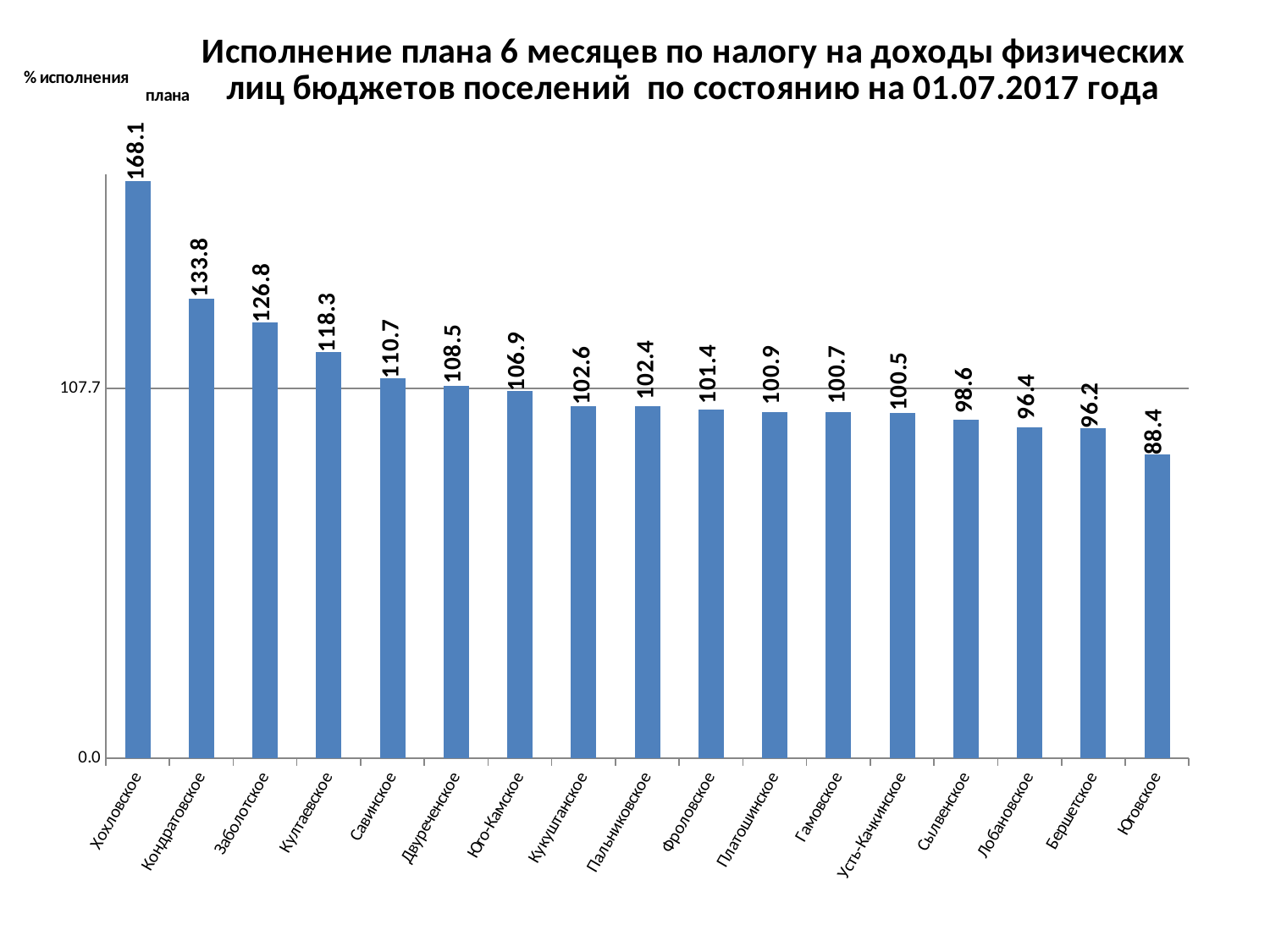
What is the value for Усть-Качкинское? 100.5 What is the value for Савинское? 110.7 Which is larger, the value for Култаевское or the value for Сылвенское? Култаевское Which category has the lowest value? Юговское What kind of chart is shown on the slide? Bar chart What is the difference between the values for Кондратовское and Заболотское? 7.0 How many categories are shown on the chart? 17 What value is marked by the horizontal reference line on the y axis? 107.7 Which category has the highest value? Хохловское What is the difference between the values for Хохловское and Юговское? 79.7 What is the value for Хохловское? 168.1 Do the values rise or fall from left to right along the x axis? Fall